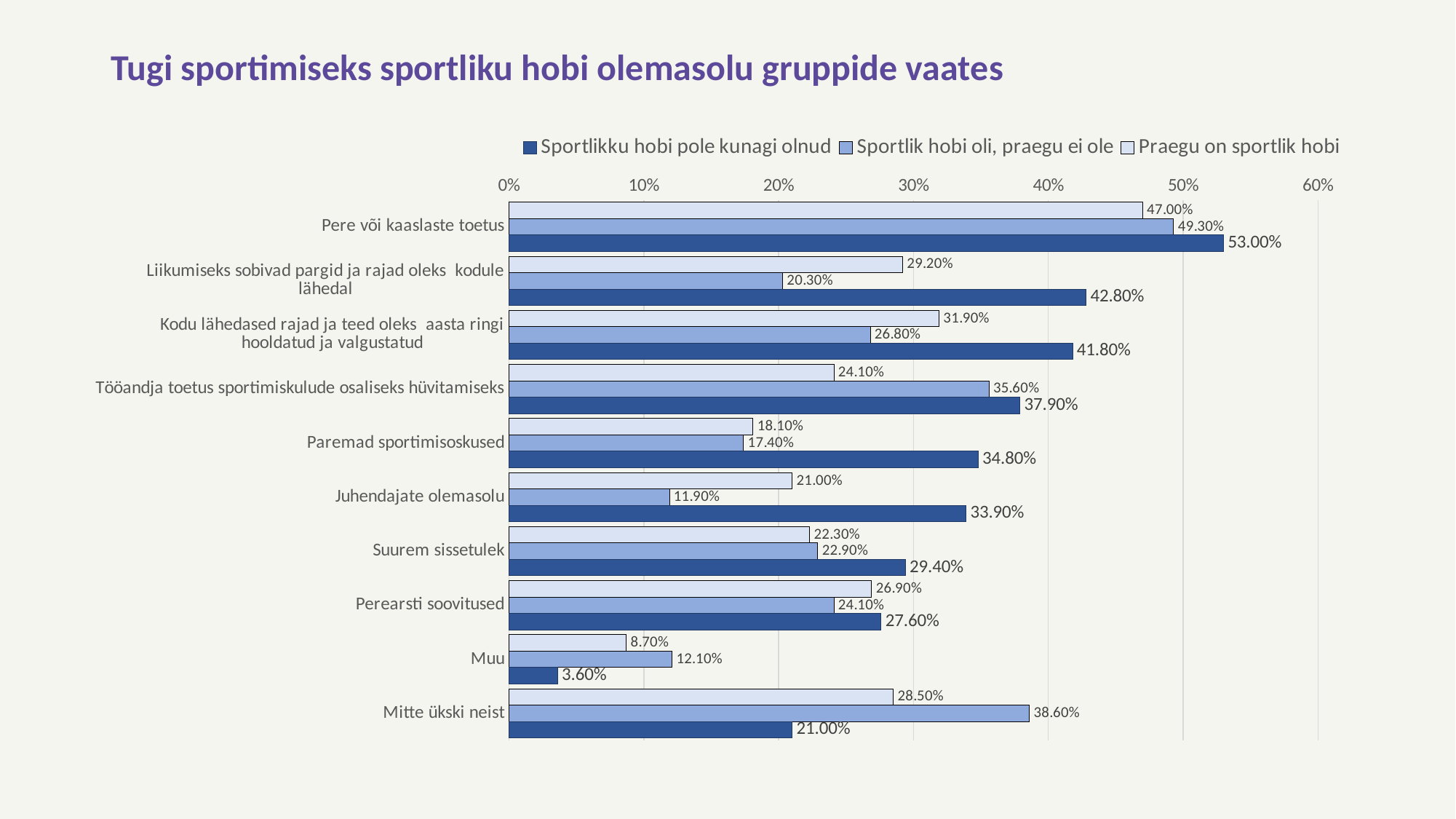
What is the value for "Pere või kaaslaste toetus" in the "Sportlikku hobi pole kunagi olnud" series? 53.00% What is the title of the chart? Tugi sportimiseks sportliku hobi olemasolu gruppide vaates What is the value for "Juhendajate olemasolu" in the "Sportlik hobi oli, praegu ei ole" series? 11.90% How many categories are shown on the chart? 10 Which category has the highest value in the "Sportlikku hobi pole kunagi olnud" series? Pere või kaaslaste toetus Is the value for "Tööandja toetus sportimiskulude osaliseks hüvitamiseks" in the "Sportlik hobi oli, praegu ei ole" series greater or less than 30%? greater Which category has the lowest value in the "Praegu on sportlik hobi" series? Muu What is the value for "Mitte ükski neist" in the "Praegu on sportlik hobi" series? 28.50% What is the difference between the "Sportlikku hobi pole kunagi olnud" and "Sportlik hobi oli, praegu ei ole" values for "Liikumiseks sobivad pargid ja rajad oleks kodule lähedal"? 22.50% What kind of chart is shown on the slide? bar chart How many series does the legend list? 3 For "Mitte ükski neist", which series has the larger value: "Sportlik hobi oli, praegu ei ole" or "Sportlikku hobi pole kunagi olnud"? Sportlik hobi oli, praegu ei ole